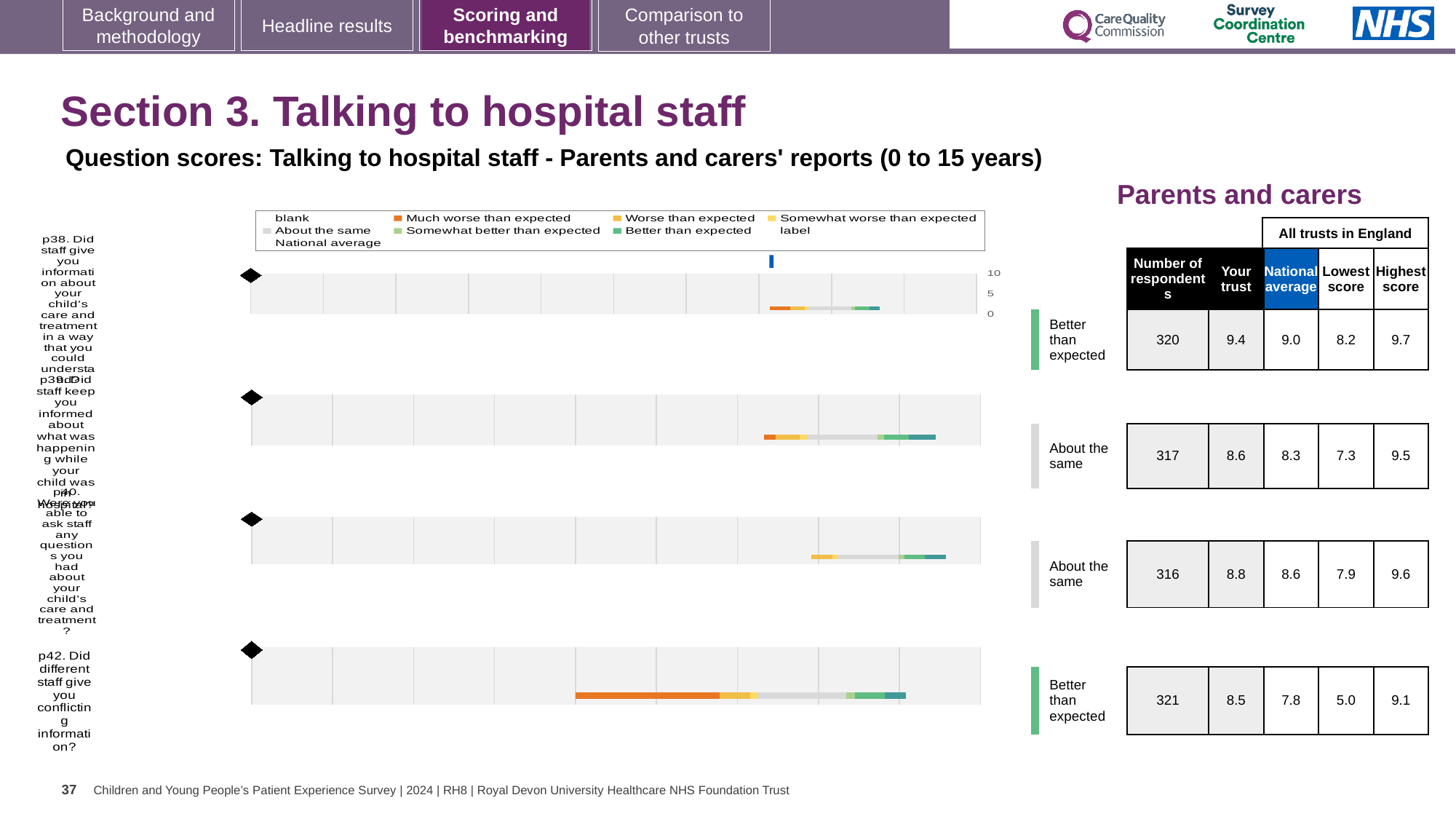
What kind of chart is used to show the question scores for p38 to p42? bar chart Which question's chart has the longest orange 'Much worse than expected' segment? p42 What is the national average score for p42 in the table beside the charts? 7.8 What is the 'Your trust' score for p38 in the table beside the charts? 9.4 How many entries does the chart legend list? 9 What benchmark label is shown next to the p38 chart? Better than expected Which question has the lowest 'Lowest score' value in the table beside the charts? p42 In the chart legend, which colour represents 'Much worse than expected'? orange Which is larger for p39: the 'Your trust' score or the national average? Your trust What is the difference between the 'Your trust' score and the national average for p42? 0.7 What benchmark label is shown next to the p39 chart? About the same How many question charts (p38, p39, p40, p42) are shown on the slide? 4